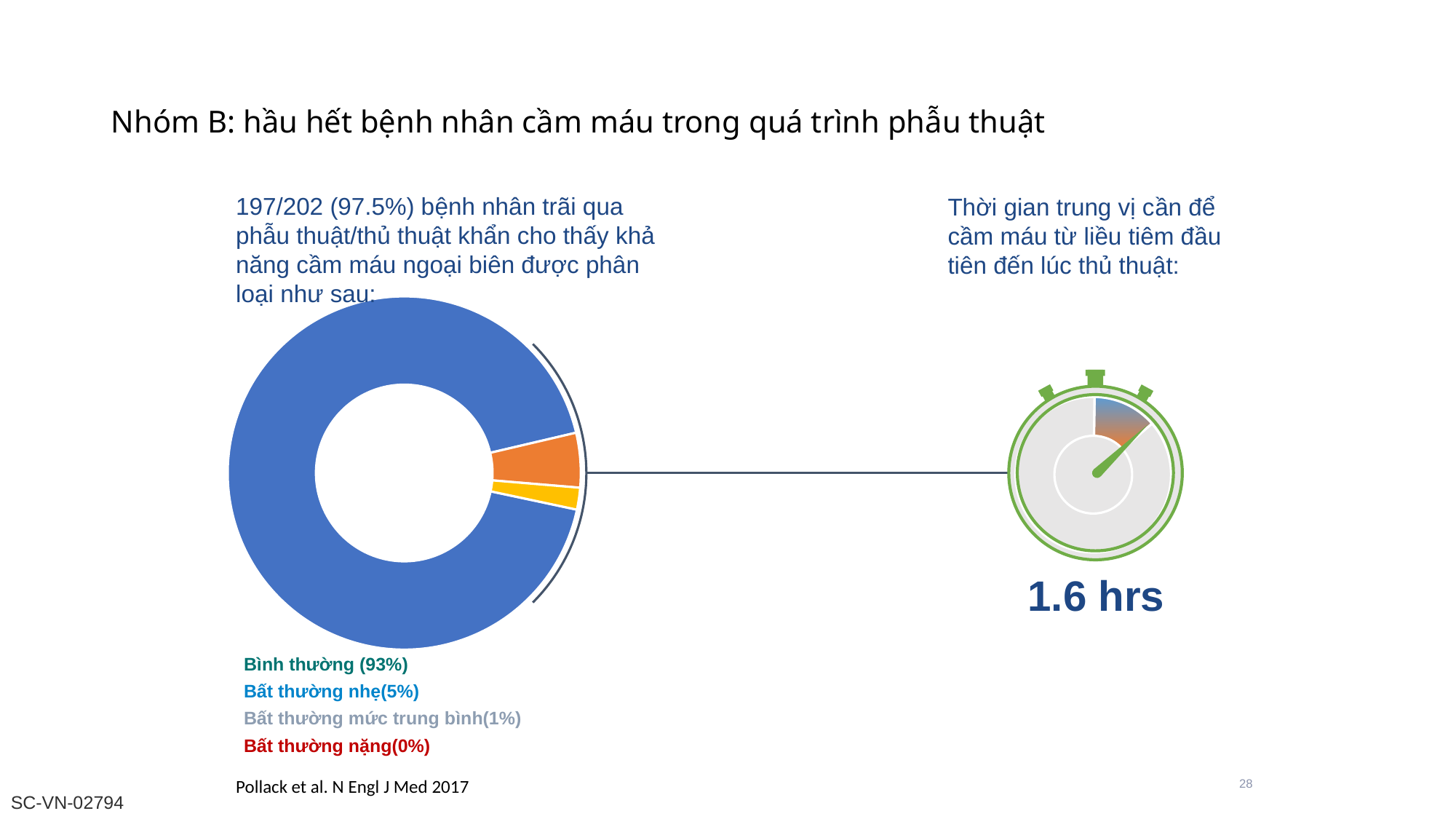
How many categories are listed below the donut chart? 4 What kind of chart is shown on the left of the slide? Pie (donut) chart What share of patients is labelled as Bình thường in the donut chart? 93% What share of patients is labelled as Bất thường nặng? 0% What share of patients is labelled as Bất thường mức trung bình? 1% How many patients (and what percentage) are stated to have undergone emergency surgery/procedures in the text above the donut chart? 197/202 (97.5%) Which category has the smallest share in the donut chart? Bất thường nặng Which is larger, the share for Bất thường nhẹ or for Bất thường mức trung bình? Bất thường nhẹ What median time is shown on the gauge on the right of the slide? 1.6 hrs What is the difference in percentage points between the Bình thường share and the Bất thường nhẹ share? 88 percentage points Which category has the largest share in the donut chart? Bình thường